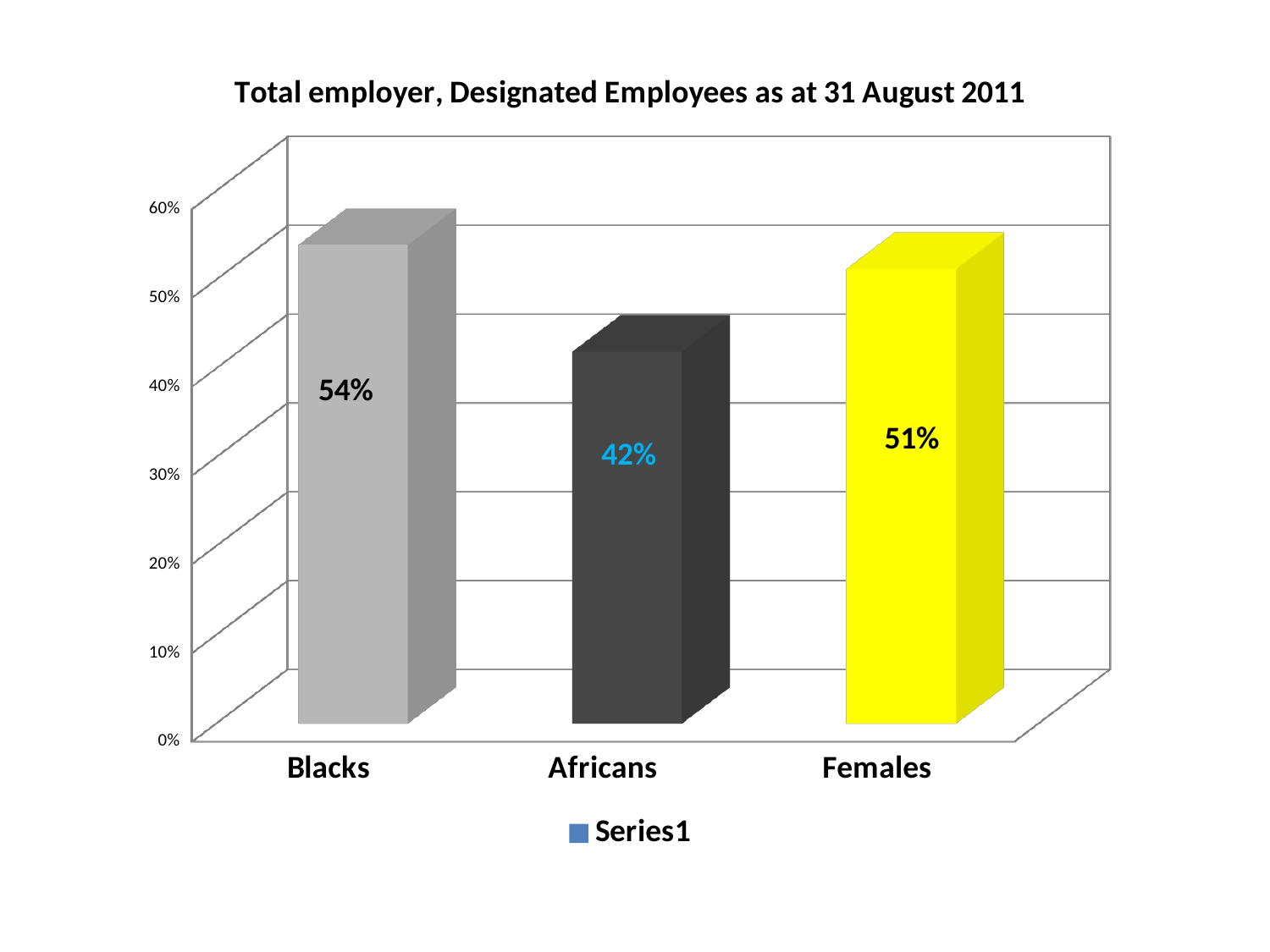
Which category has the highest value? Blacks Which is larger, the value for Blacks or the value for Females? Blacks What is the title of the chart? Total employer, Designated Employees as at 31 August 2011 Is the value for Africans greater or less than 50%? less What is the value for Blacks? 54% What is the value for Africans? 42% Which category has the lowest value? Africans What is the value for Females? 51% How many categories are shown on the chart? 3 What is the difference between the values for Blacks and Africans? 12% What kind of chart is shown on the slide? bar chart What is the difference between the values for Females and Africans? 9%